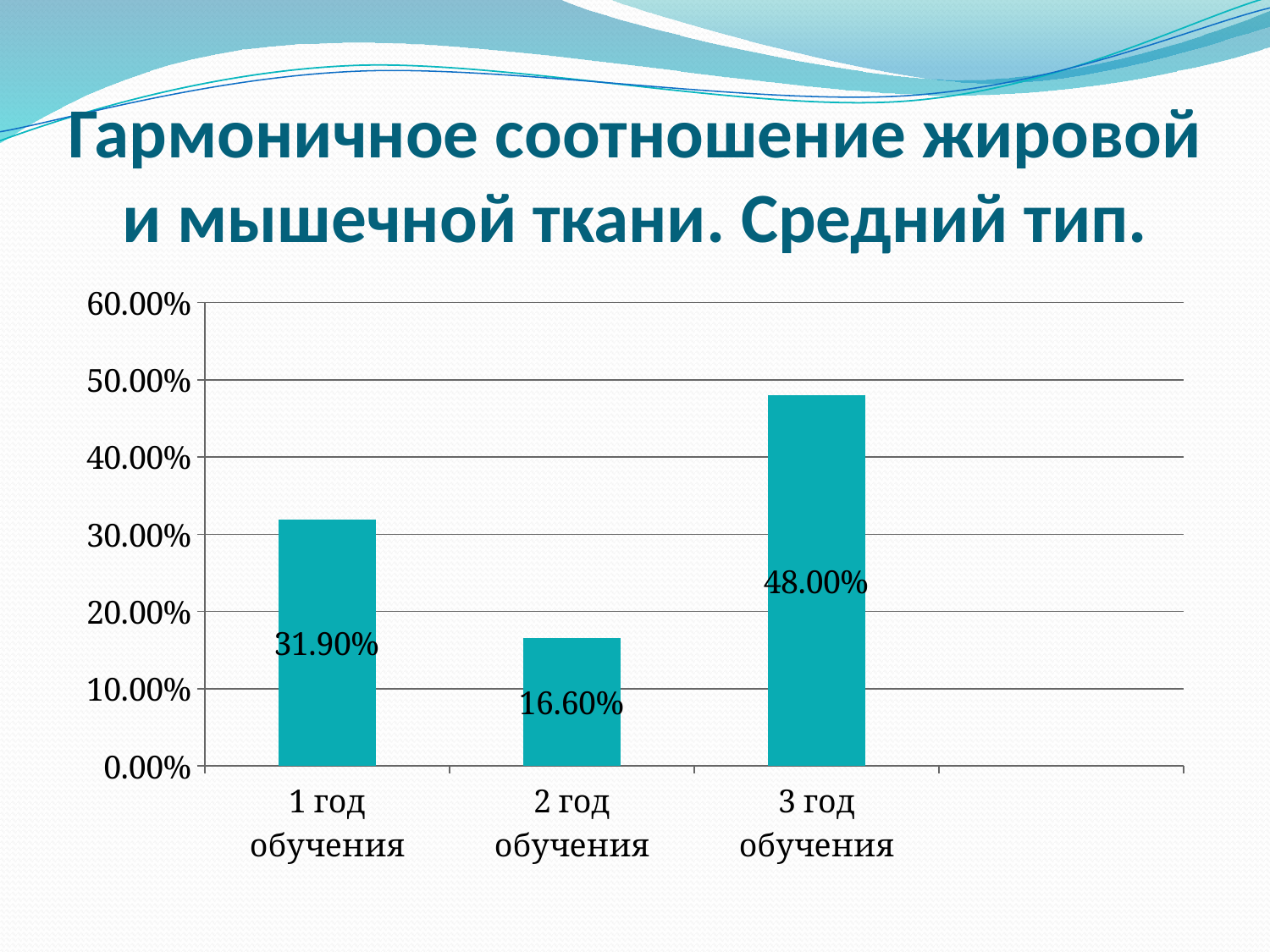
Which category has the lowest value? 2 год обучения What kind of chart is shown on the slide? bar chart What is the difference between the values for 3 год обучения and 1 год обучения? 16.10% Which is larger, the value for 1 год обучения or 2 год обучения? 1 год обучения Is the value for 3 год обучения greater or less than 40.00%? greater How many categories are shown on the x axis? 3 What is the value for 1 год обучения? 31.90% What is the value for 2 год обучения? 16.60% What is the title of the slide? Гармоничное соотношение жировой и мышечной ткани. Средний тип. Which category has the highest value? 3 год обучения What is the value for 3 год обучения? 48.00% What is the difference between the values for 1 год обучения and 2 год обучения? 15.30%